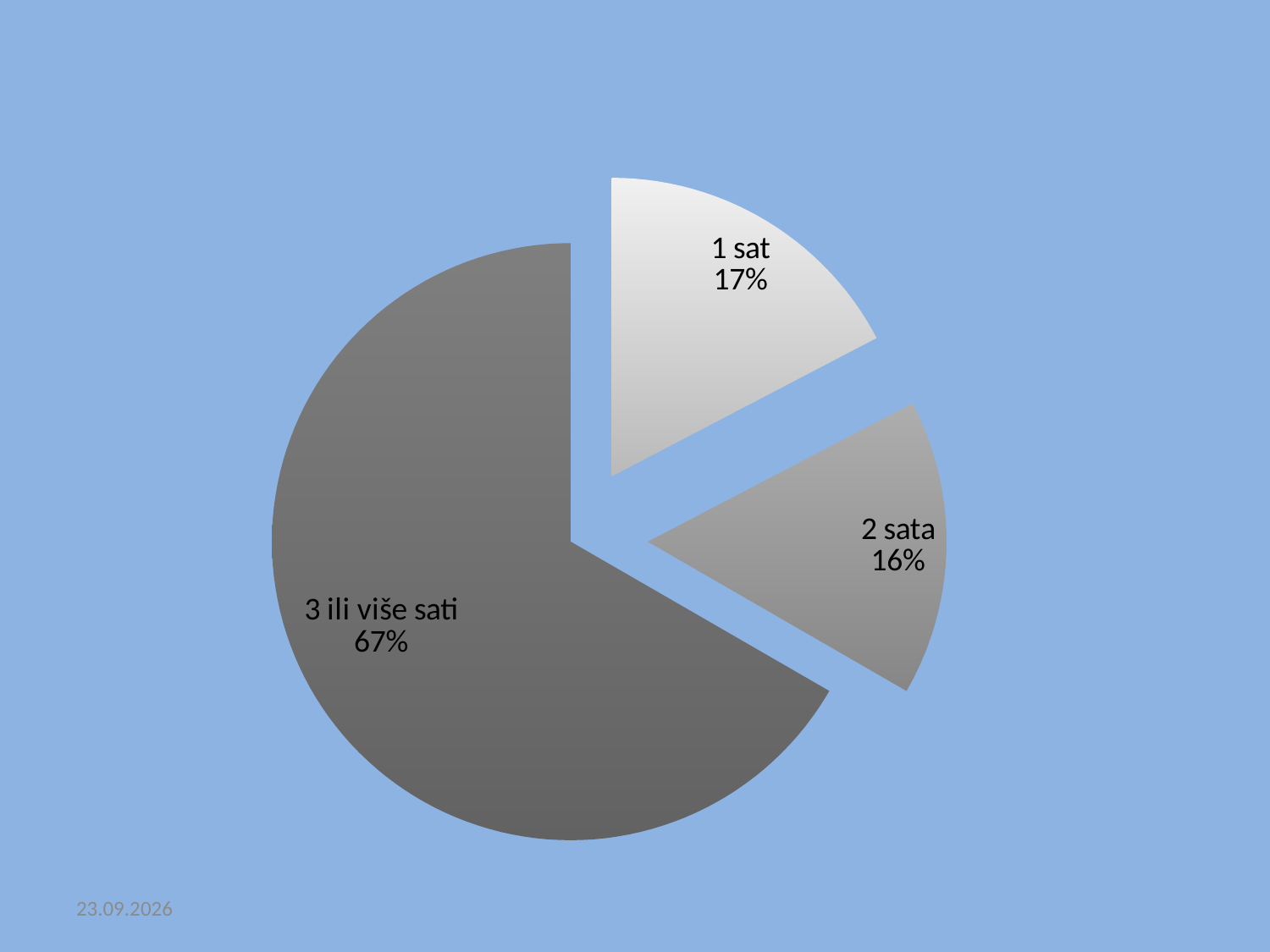
What share of the pie does the "3 ili više sati" slice represent? 67% Which slice of the pie is the largest? 3 ili više sati Which slice of the pie is the smallest? 2 sata Which slice of the pie is the darkest in colour? 3 ili više sati How many slices does the pie chart have? 3 What share of the pie does the "2 sata" slice represent? 16% What is the difference in percentage points between the "1 sat" slice and the "2 sata" slice? 1 Which is larger, the "3 ili više sati" slice or the "2 sata" slice? 3 ili više sati What kind of chart is shown on the slide? pie chart What is the difference in percentage points between the "3 ili više sati" slice and the "1 sat" slice? 50 Is the share for "3 ili više sati" greater or less than 50%? greater What share of the pie does the "1 sat" slice represent? 17%